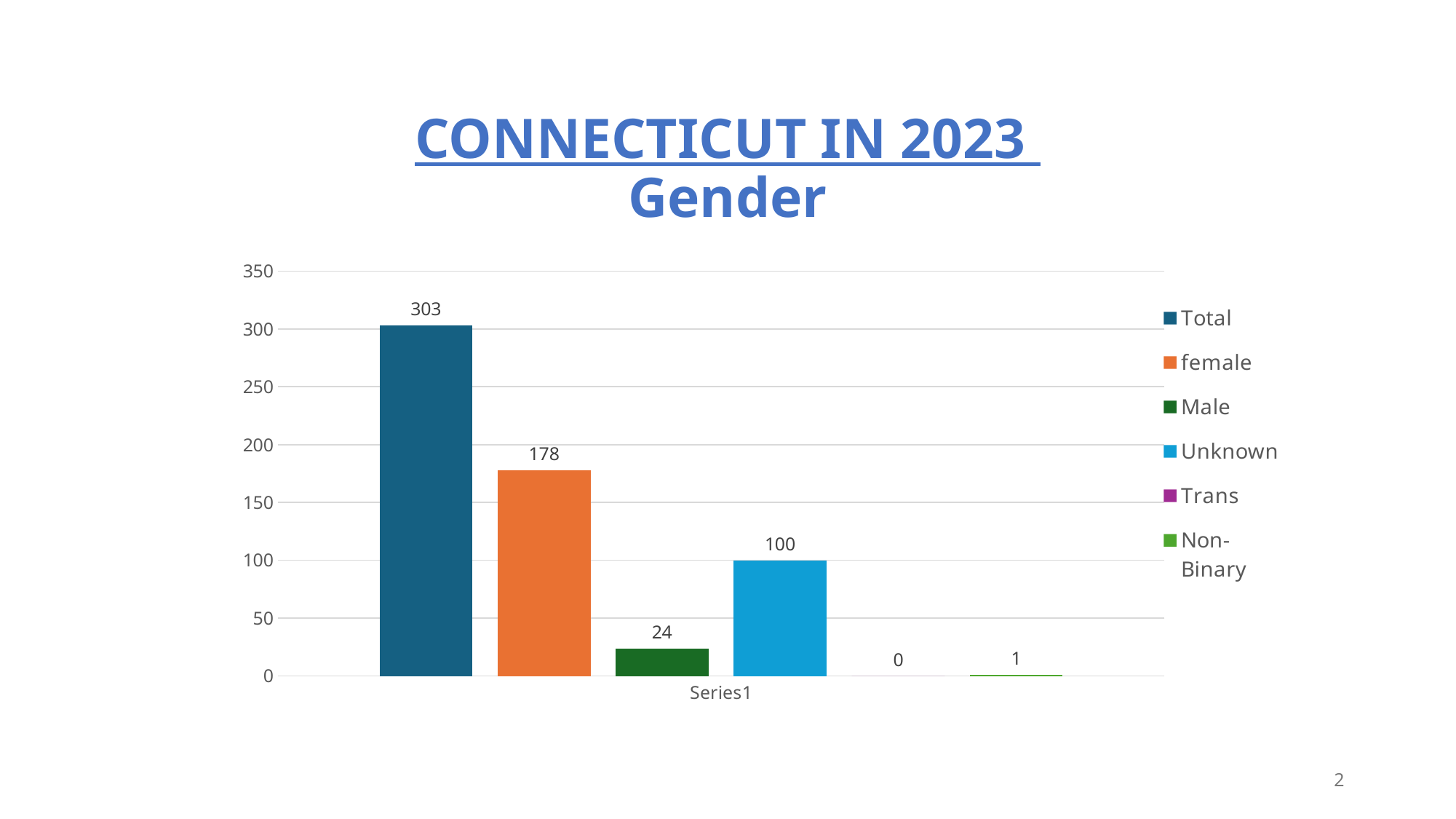
Which series has the lowest value? Trans What kind of chart is shown on the slide? Bar chart What is the value for Unknown? 100 What is the value for Non-Binary? 1 What is the value for Trans? 0 What is the value for Total? 303 Which series has the highest value? Total What is the value for Male? 24 What is the value for female? 178 How many series does the legend list? 6 Which is larger, the value for Unknown or the value for Male? Unknown What is the difference between the female and Male values? 154